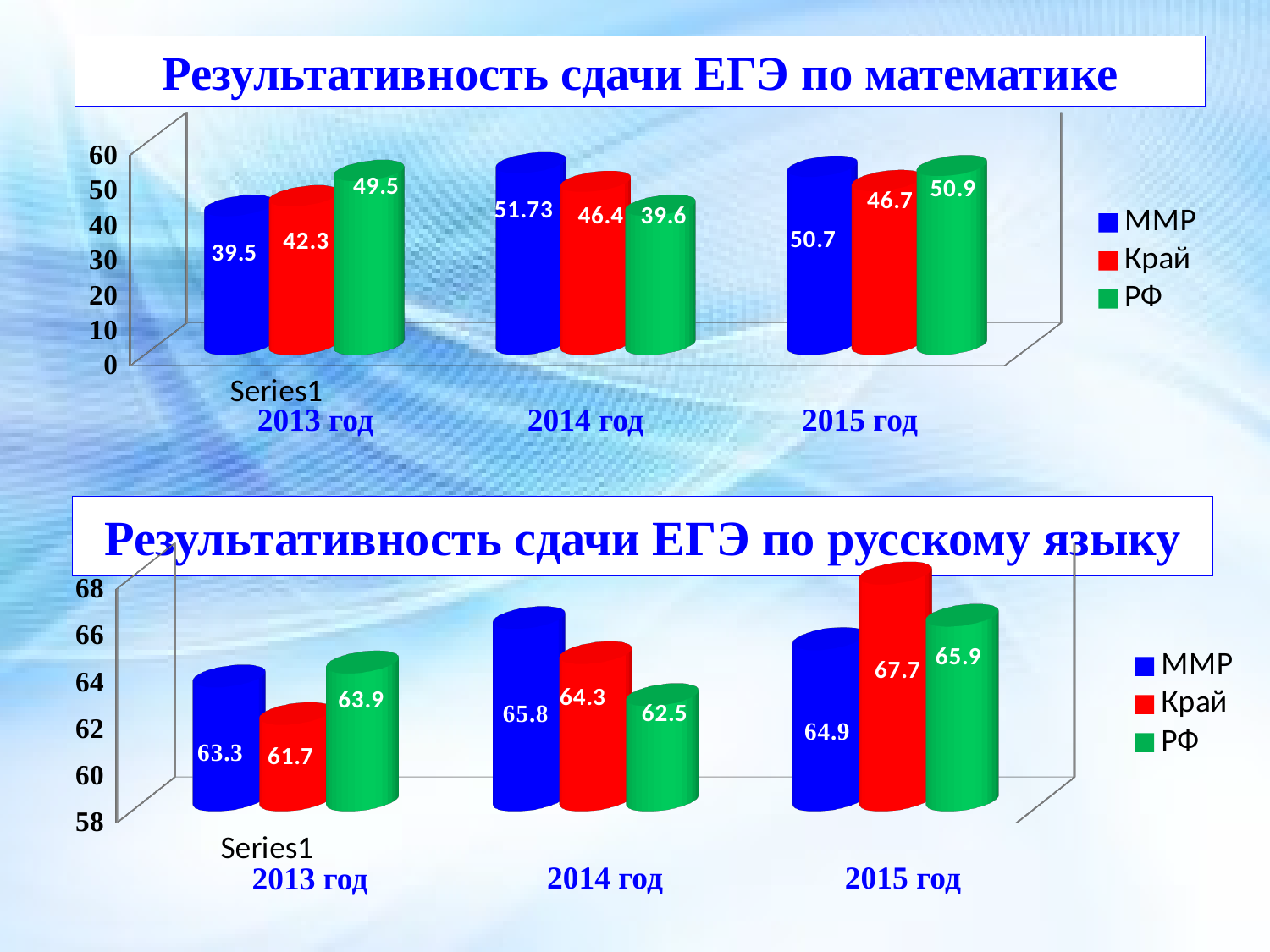
In the chart 'Результативность сдачи ЕГЭ по математике', what is the difference between the Край values for 2015 год and 2013 год? 4.4 In the chart 'Результативность сдачи ЕГЭ по русскому языку', which series has the highest value in 2015 год? Край In the chart 'Результативность сдачи ЕГЭ по математике', what is the value for ММР in 2014 год? 51.73 In the chart 'Результативность сдачи ЕГЭ по русскому языку', which is larger in 2013 год: ММР or Край? ММР In the chart 'Результативность сдачи ЕГЭ по математике', which series has the lowest value in 2014 год? РФ How many series does the legend of the chart 'Результативность сдачи ЕГЭ по математике' list? 3 In the chart 'Результативность сдачи ЕГЭ по русскому языку', what is the value for РФ in 2014 год? 62.5 In the chart 'Результативность сдачи ЕГЭ по математике', what is the value for РФ in 2013 год? 49.5 What type of chart is 'Результативность сдачи ЕГЭ по русскому языку'? Bar chart In the chart 'Результативность сдачи ЕГЭ по русскому языку', what is the value for Край in 2015 год? 67.7 In the chart 'Результативность сдачи ЕГЭ по русскому языку', what is the difference between ММР and РФ in 2014 год? 3.3 In the chart 'Результативность сдачи ЕГЭ по математике', how does the ММР value change from 2013 год to 2014 год? It rises